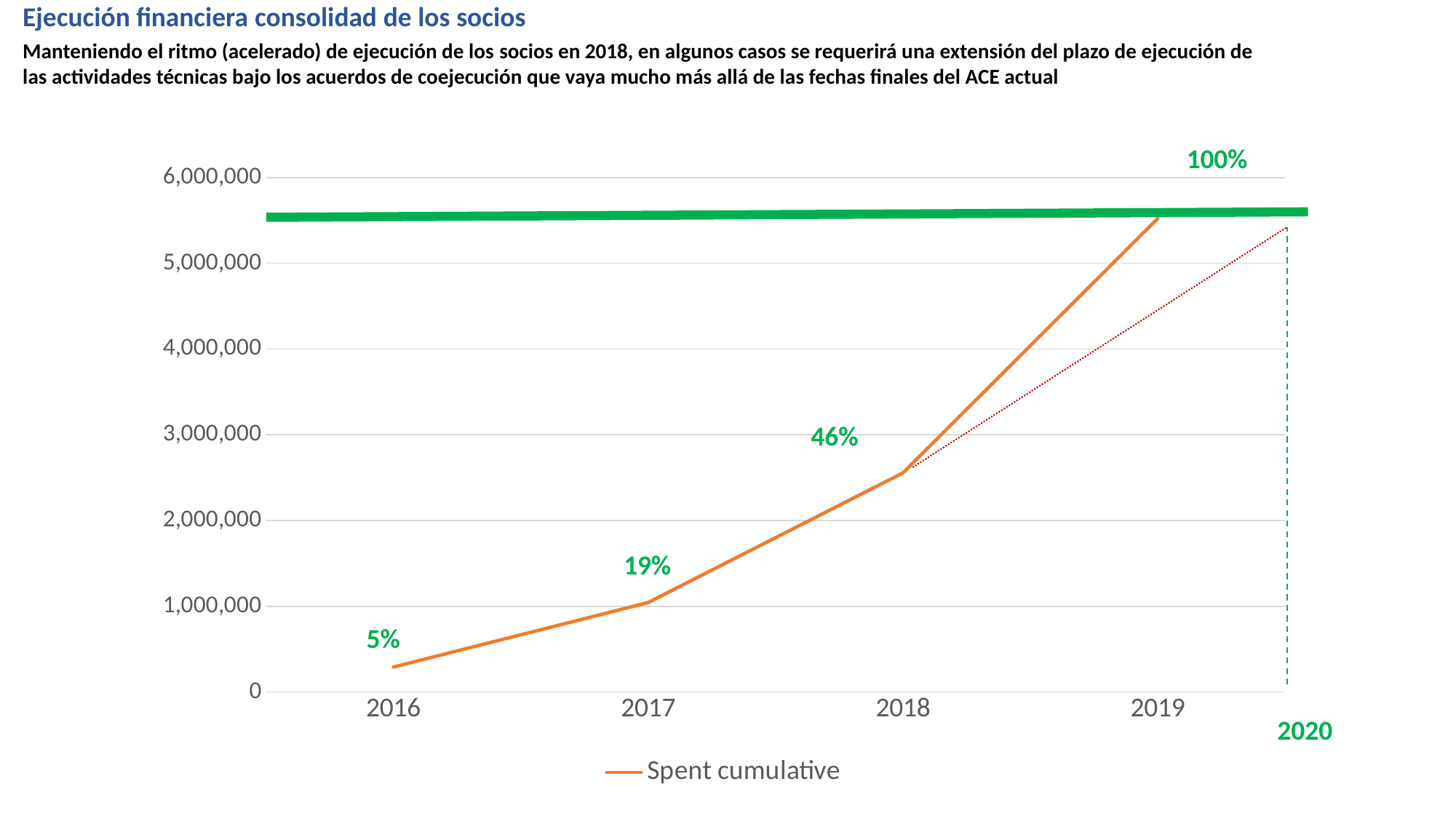
What series name does the legend show? Spent cumulative What kind of chart is shown on the slide? line chart Does the Spent cumulative line rise or fall from 2016 to 2019? rise What percentage label is shown for 2016? 5% Is the Spent cumulative value for 2016 greater or less than 1,000,000? less What percentage label is shown for 2017? 19% What percentage label is shown for 2018? 46% How many series does the legend list? 1 Is the Spent cumulative value for 2018 greater or less than 2,000,000? greater Is the Spent cumulative value for 2019 greater or less than 5,000,000? greater In which year is the Spent cumulative value lowest? 2016